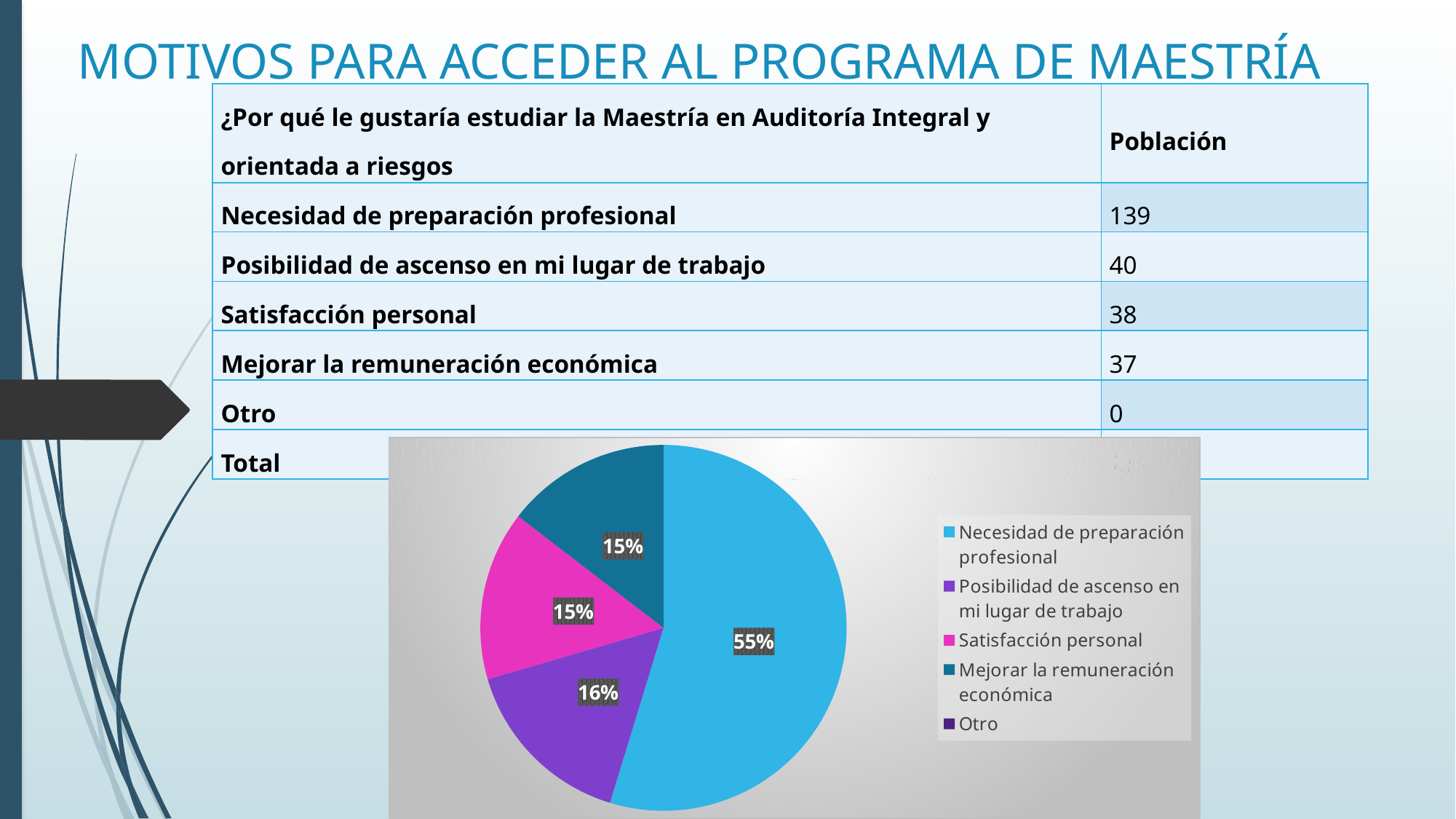
What percentage is shown for 'Satisfacción personal'? 15% What is the difference in percentage points between 'Posibilidad de ascenso en mi lugar de trabajo' and 'Satisfacción personal'? 1 percentage point What type of chart is shown on the slide? pie chart What share of the pie does 'Necesidad de preparación profesional' represent? 55% What percentage is shown for 'Posibilidad de ascenso en mi lugar de trabajo'? 16% What percentage is shown for 'Mejorar la remuneración económica'? 15% How many slices with percentage labels are visible in the pie chart? 4 Which category has the largest slice of the pie? Necesidad de preparación profesional Which legend entry has no visible slice in the pie chart? Otro Which is larger, the slice for 'Necesidad de preparación profesional' or the slice for 'Posibilidad de ascenso en mi lugar de trabajo'? Necesidad de preparación profesional How many entries does the legend of the pie chart list? 5 What is the difference in percentage points between 'Necesidad de preparación profesional' and 'Posibilidad de ascenso en mi lugar de trabajo'? 39 percentage points